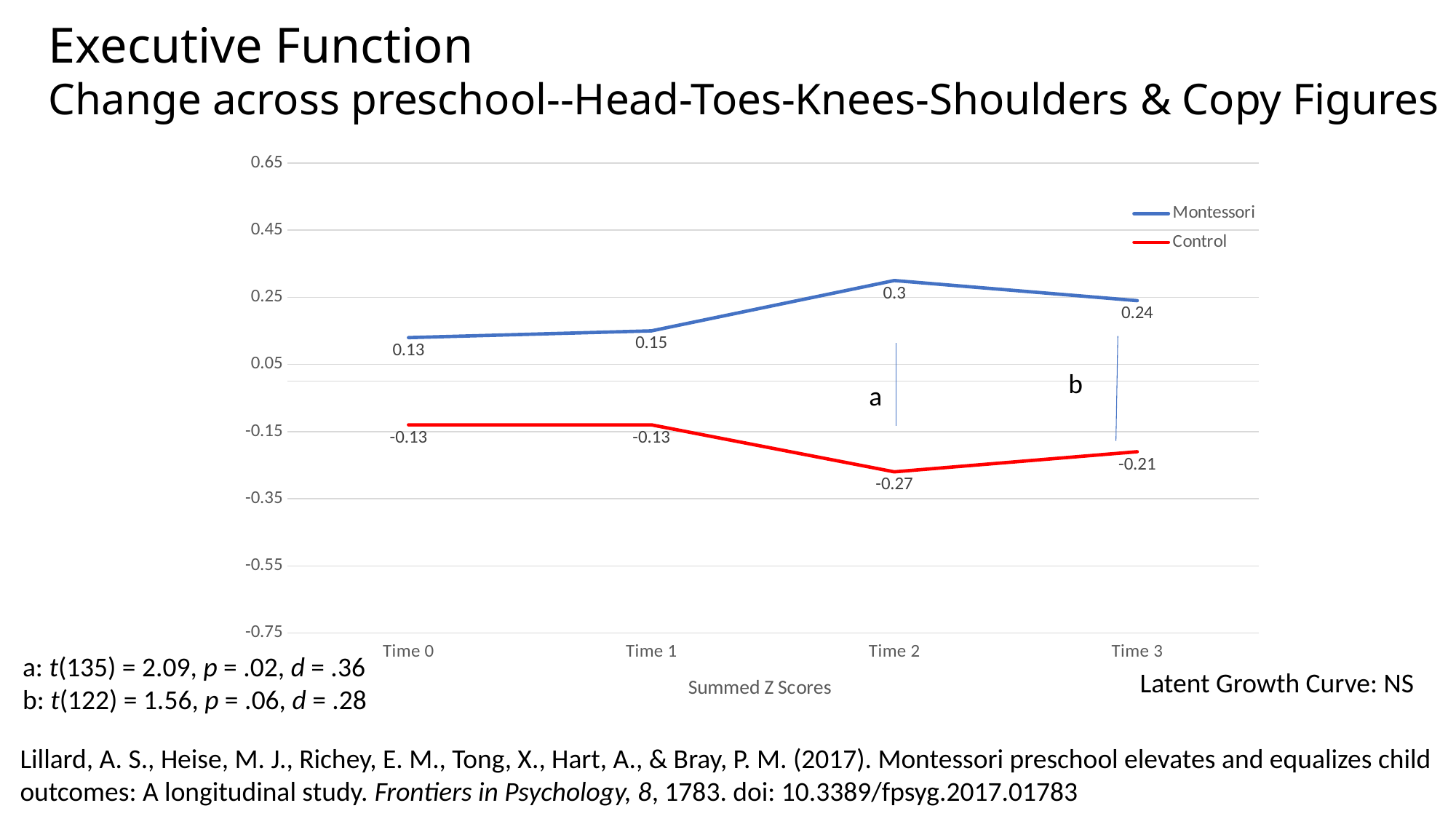
What is the Control value at Time 2? -0.27 How many series does the legend list? 2 What kind of chart is shown on the slide? Line chart Which series has the larger value at Time 3, Montessori or Control? Montessori How many time points are plotted on the x axis? 4 What is the Control value at Time 3? -0.21 What is the Montessori value at Time 0? 0.13 What is the difference between the Montessori and Control values at Time 2? 0.57 At which time point is the Control value lowest? Time 2 What is the x-axis label of the chart? Summed Z Scores What is the Montessori value at Time 2? 0.3 At which time point is the Montessori value highest? Time 2